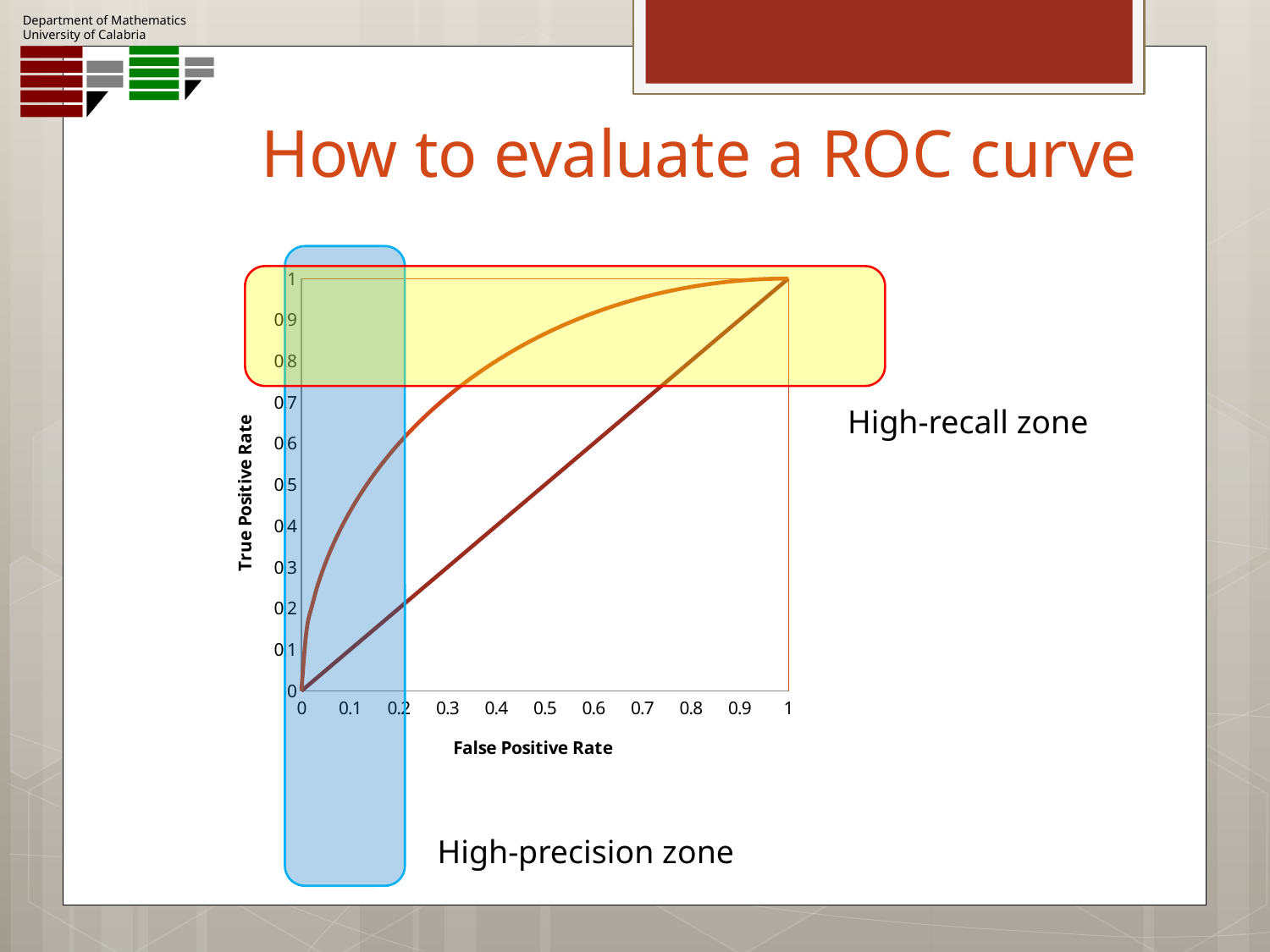
Is the True Positive Rate of the straight diagonal line at a False Positive Rate of 0.2 greater or less than 0.5? less What is the title of the y axis of the chart? True Positive Rate What is the True Positive Rate of the curved line when the False Positive Rate is 1? 1 Does the curved line rise or fall as the False Positive Rate increases from 0 to 1? rise What is the title of the x axis of the chart? False Positive Rate What kind of chart is shown on the slide? line chart At a False Positive Rate of 0.4, which line has the higher True Positive Rate, the curved line or the straight diagonal line? the curved line How many lines are plotted on the chart? 2 Is the True Positive Rate of the curved line at a False Positive Rate of 0.2 greater or less than 0.5? greater Is the True Positive Rate of the curved line at a False Positive Rate of 0.5 greater or less than 0.7? greater What is the highest value shown on the True Positive Rate axis? 1 What is the True Positive Rate of the curved line when the False Positive Rate is 0? 0